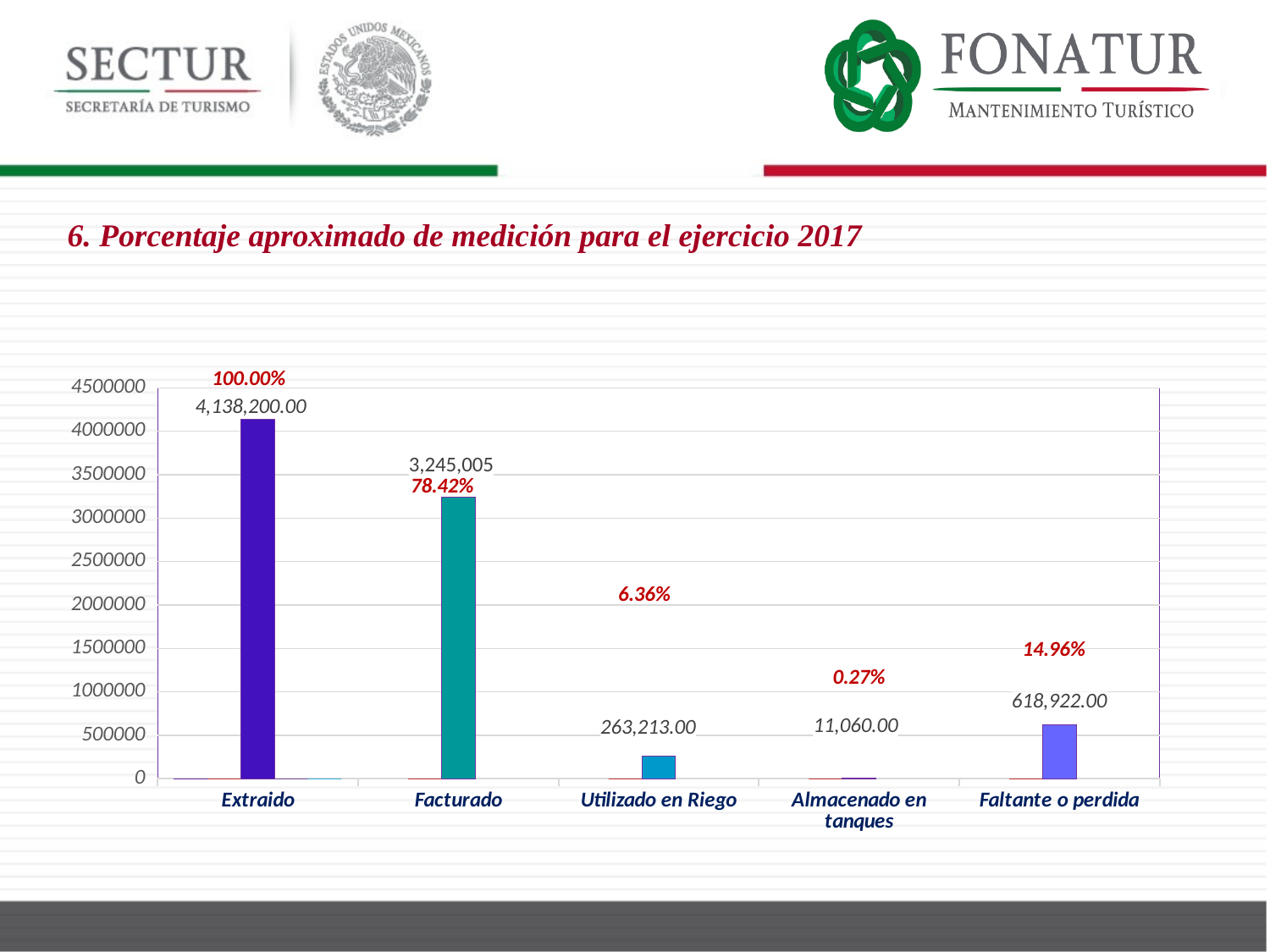
How many categories are shown on the x axis? 5 What is the value shown for Extraido? 4,138,200.00 What percentage is shown for Facturado? 78.42% What is the title of the slide above the chart? 6. Porcentaje aproximado de medición para el ejercicio 2017 What percentage is shown for Faltante o perdida? 14.96% Which is larger, the value for Faltante o perdida or the value for Utilizado en Riego? Faltante o perdida What is the value shown for Almacenado en tanques? 11,060.00 What is the value shown for Facturado? 3,245,005 Which category has the lowest value? Almacenado en tanques What is the value shown for Utilizado en Riego? 263,213.00 What kind of chart is shown on the slide? bar chart Which category has the highest value? Extraido